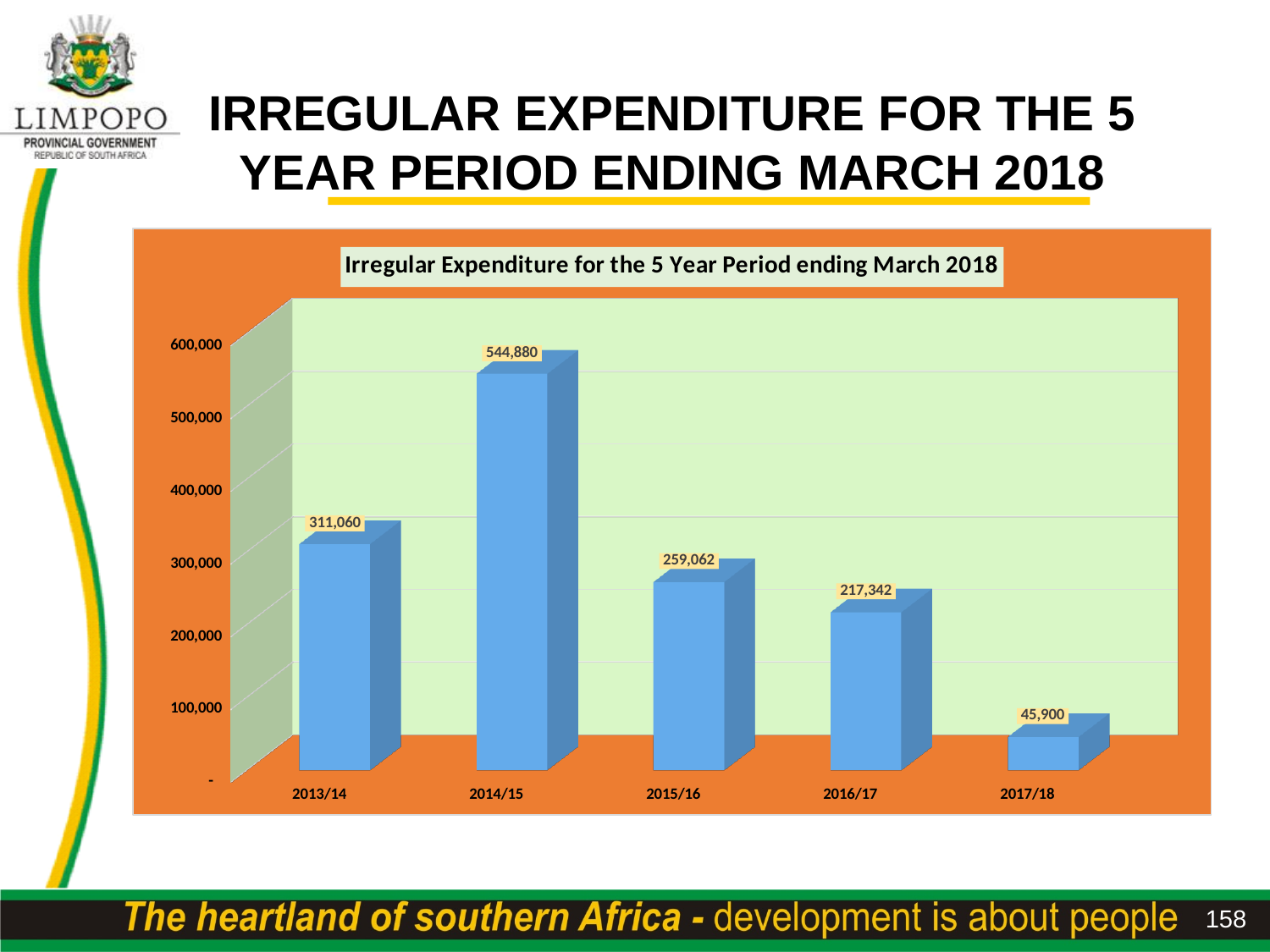
What is the irregular expenditure value for 2014/15? 544,880 What is the title of the chart? Irregular Expenditure for the 5 Year Period ending March 2018 What is the difference between the irregular expenditure for 2015/16 and 2016/17? 41,720 What kind of chart is shown on the slide? bar chart Is the value for 2016/17 greater or less than 300,000? less Which year has the highest irregular expenditure? 2014/15 What is the difference between the irregular expenditure for 2014/15 and 2013/14? 233,820 What is the irregular expenditure value for 2017/18? 45,900 How many years are shown on the chart? 5 What is the irregular expenditure value for 2013/14? 311,060 Which is larger, the irregular expenditure for 2015/16 or 2016/17? 2015/16 Which year has the lowest irregular expenditure? 2017/18